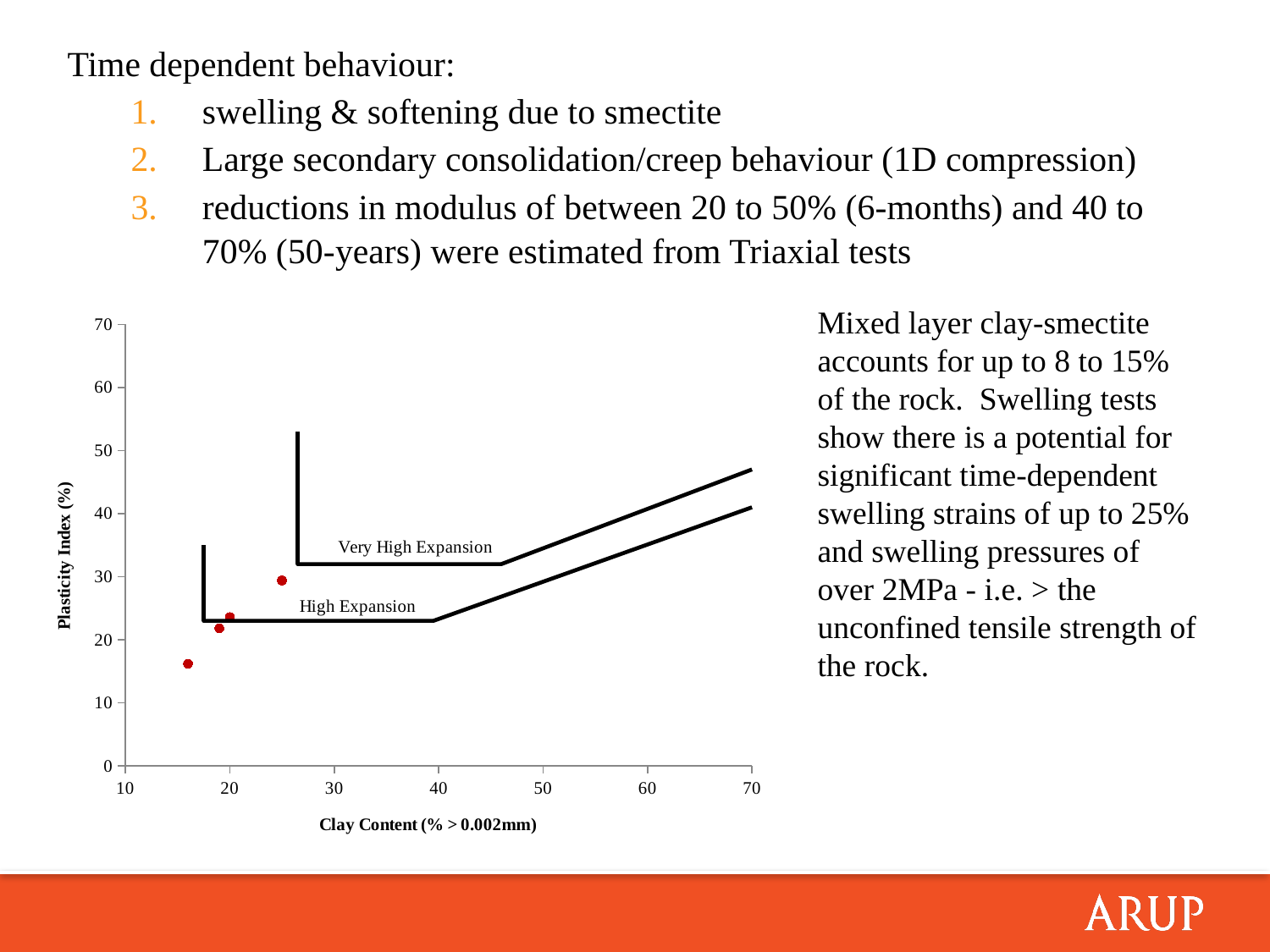
Is the plasticity index of the rightmost data point greater or less than 40? less How many red data points are plotted on the chart? 4 What kind of chart is shown on the slide? scatter chart Is the clay content of the leftmost data point greater or less than 20? less Do all four data points fall below a plasticity index of 40? yes What is the maximum value shown on the y axis of the chart? 70 What is the label of the y axis of the chart? Plasticity Index (%) Which data point has the highest plasticity index: the leftmost or the rightmost? the rightmost What is the label of the x axis of the chart? Clay Content (% > 0.002mm)